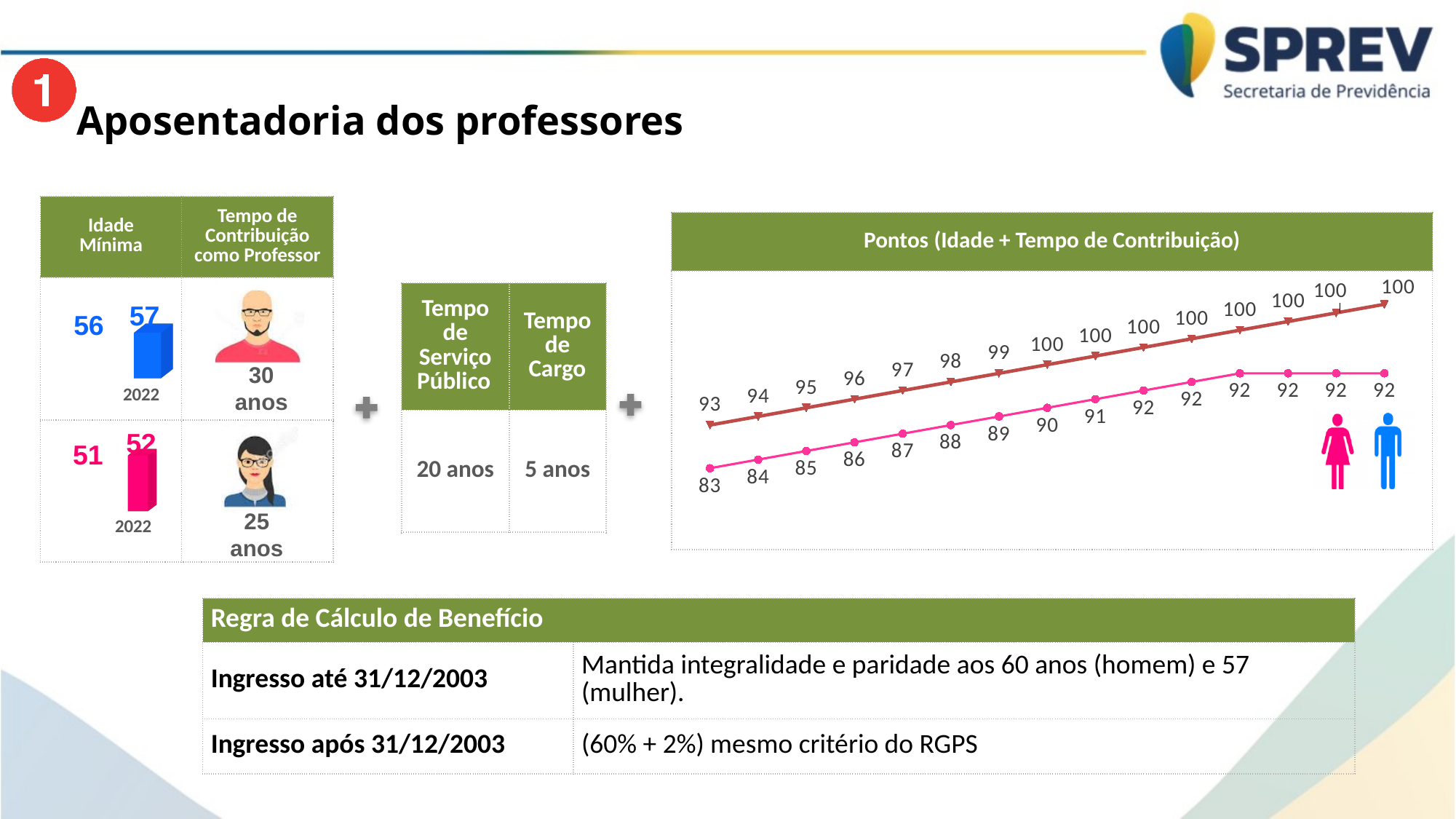
In the 'Pontos' chart, what is the lowest value on the pink line? 83 What kind of chart is shown under the heading 'Pontos (Idade + Tempo de Contribuição)'? line chart In the 'Pontos' chart, what is the difference between the final values of the red line (100) and the pink line (92)? 8 In the 'Pontos' chart, what is the highest value reached by the pink line? 92 In the 'Pontos' chart, what is the first value of the lower (pink) line? 83 In the 'Pontos' chart, do the values of the pink line rise or fall from left to right before levelling off? rise In the 'Pontos' chart, which line has higher values throughout, the red line or the pink line? the red line What is the title of the chart on the right side of the slide? Pontos (Idade + Tempo de Contribuição) In the 'Pontos' chart, what is the first value of the upper (red) line? 93 How many data points are plotted on the red line in the 'Pontos' chart? 15 In the 'Pontos' chart, what is the highest value reached by the red line? 100 In the 'Pontos' chart, what is the difference between the first values of the red line (93) and the pink line (83)? 10